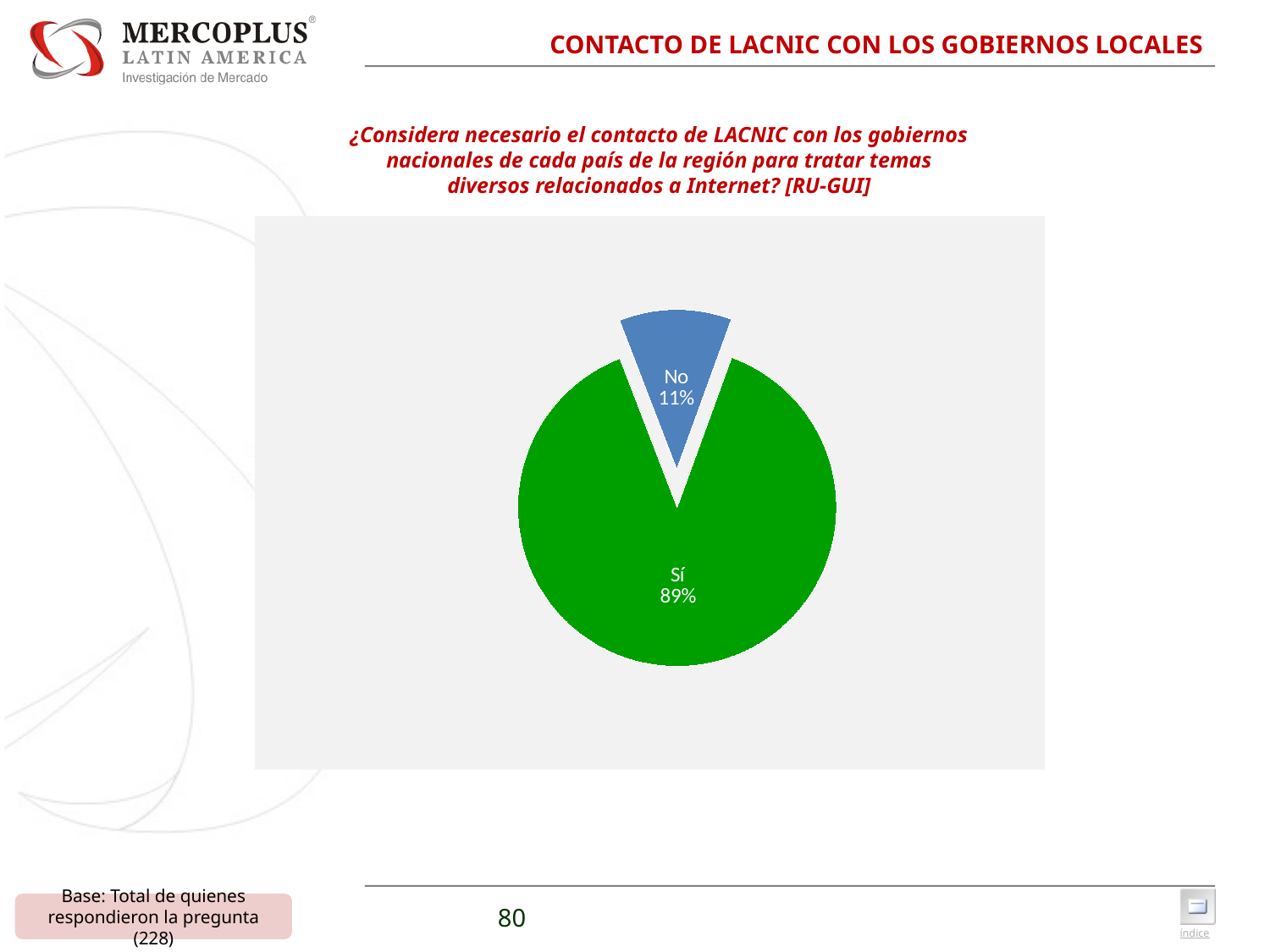
How many slices does the pie chart have? 2 Is the share for "Sí" greater or less than 50%? greater What share of the pie does the "No" slice represent? 11% What is the difference in percentage points between the "Sí" and "No" slices? 78 Which response has the largest share of the pie? Sí What colour is the "Sí" slice? Green What colour is the "No" slice? Blue Which slice is larger, "Sí" or "No"? Sí What percentage of respondents answered "No"? 11% What percentage of respondents answered "Sí"? 89% What type of chart is shown on the slide? Pie chart Which response has the smallest share of the pie? No